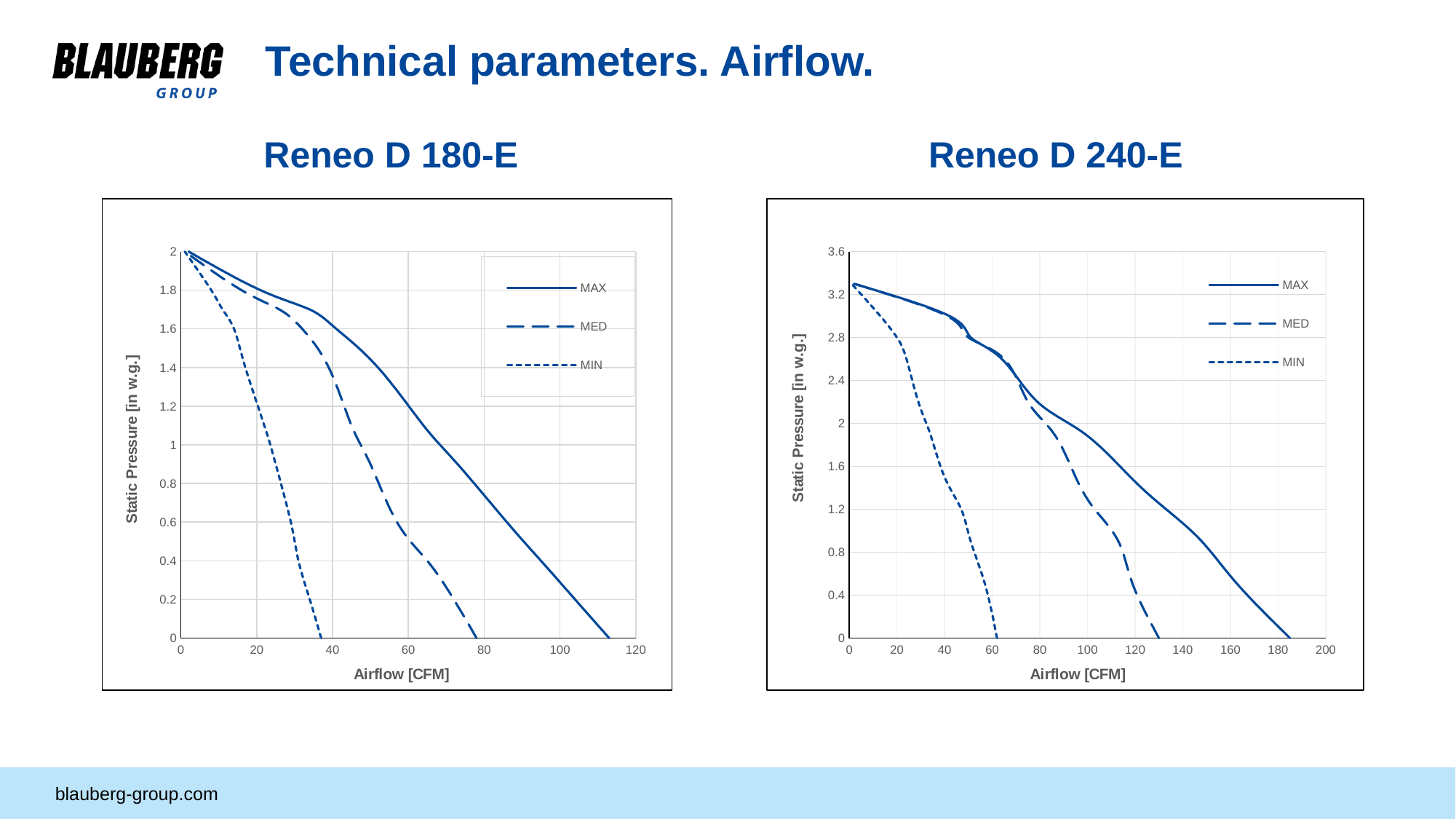
In the Reneo D 240-E chart, is the MED static pressure at 120 CFM greater or less than 0.8? less In the Reneo D 240-E chart, does the MIN curve rise or fall as airflow increases? fall What is the highest tick value shown on the y-axis of the Reneo D 240-E chart? 3.6 In the Reneo D 180-E chart, does the MAX curve rise or fall as airflow increases? fall In the Reneo D 180-E chart, is the MAX static pressure at 40 CFM greater or less than 1.4? greater In the Reneo D 180-E chart, at 60 CFM, which series has the higher static pressure, MAX or MED? MAX In the Reneo D 180-E chart, is the MED static pressure at 60 CFM greater or less than 0.8? less What is the x-axis title of the Reneo D 240-E chart? Airflow [CFM] How many series does the legend of the Reneo D 240-E chart list? 3 In the Reneo D 240-E chart, at 80 CFM, which series has the higher static pressure, MAX or MIN? MAX What kind of chart is the Reneo D 180-E chart? line chart